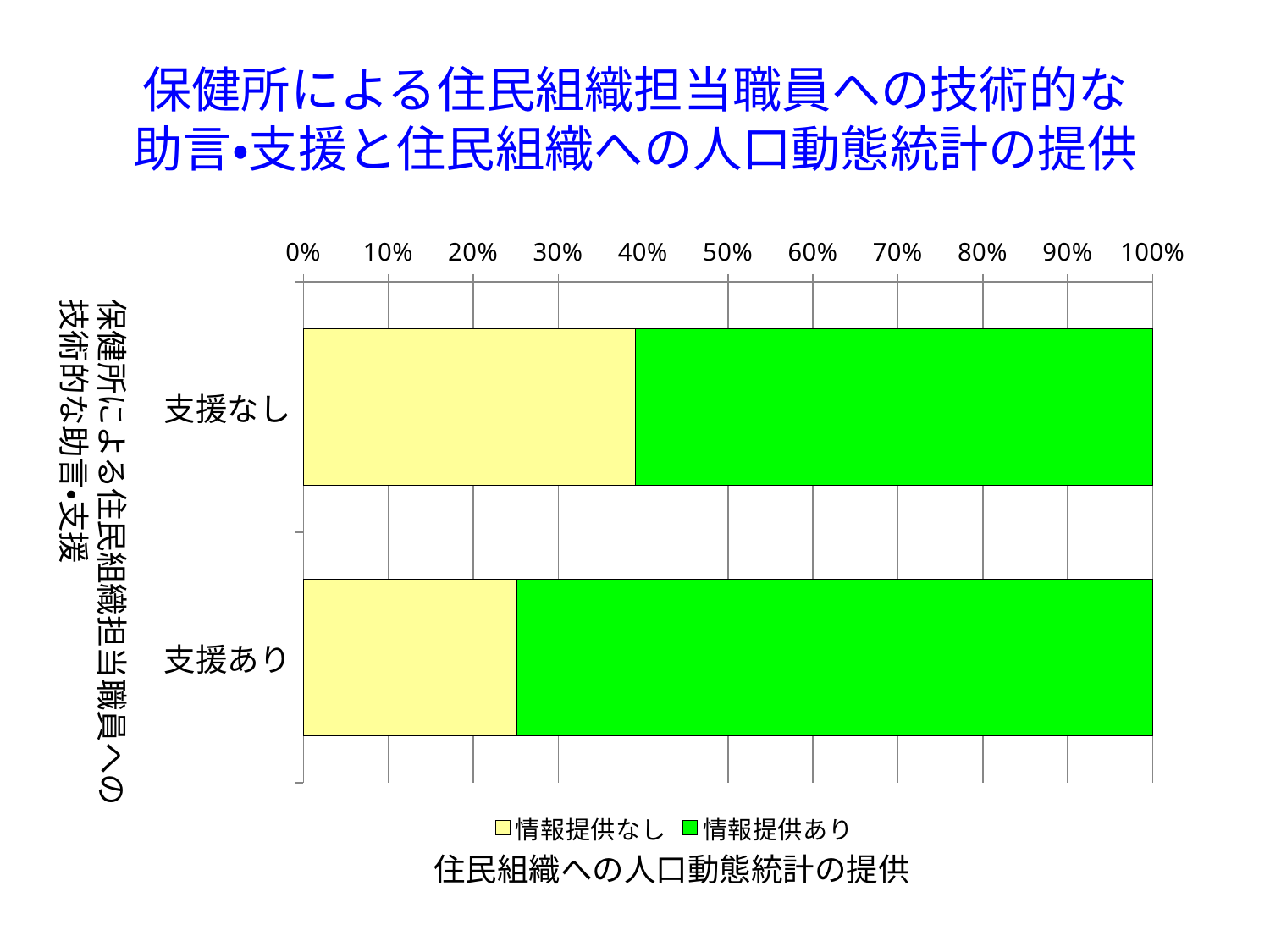
Is the 情報提供なし share for 支援あり greater or less than 30%? less What kind of chart is shown on the slide? bar chart Is the 情報提供あり share for 支援なし greater or less than 50%? greater Is the 情報提供なし share for 支援なし greater or less than 30%? greater Which category has the larger 情報提供なし share, 支援なし or 支援あり? 支援なし What is the title of the horizontal axis of the chart? 住民組織への人口動態統計の提供 Which series is shown in green in the chart? 情報提供あり Which category has the larger 情報提供あり share, 支援なし or 支援あり? 支援あり How many series does the legend list? 2 How many categories are shown on the vertical axis of the chart? 2